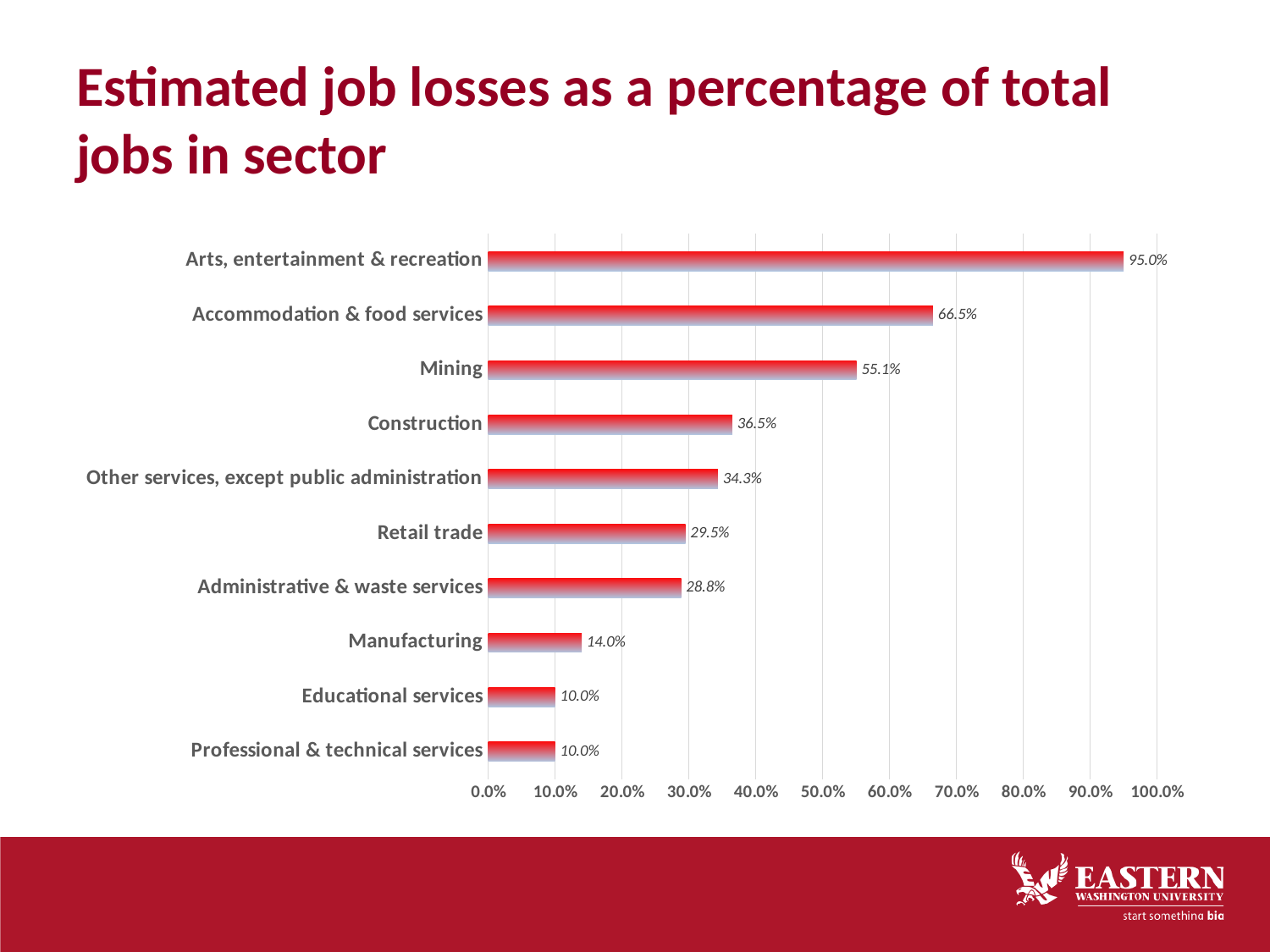
What is the estimated job loss percentage for Mining? 55.1% What is the title of the slide? Estimated job losses as a percentage of total jobs in sector What is the estimated job loss percentage for Retail trade? 29.5% What kind of chart is shown on the slide? Bar chart Which sector has the highest estimated job loss percentage? Arts, entertainment & recreation What is the estimated job loss percentage for Accommodation & food services? 66.5% Which sector has the lowest estimated job loss percentage, other than the tie between Educational services and Professional & technical services? Manufacturing What is the difference in estimated job loss percentage between Construction and Other services, except public administration? 2.2% What is the difference in estimated job loss percentage between Arts, entertainment & recreation and Accommodation & food services? 28.5% Is the value for Administrative & waste services greater or less than 30.0%? less Which has a higher estimated job loss percentage, Mining or Construction? Mining How many sectors are shown in the chart? 10